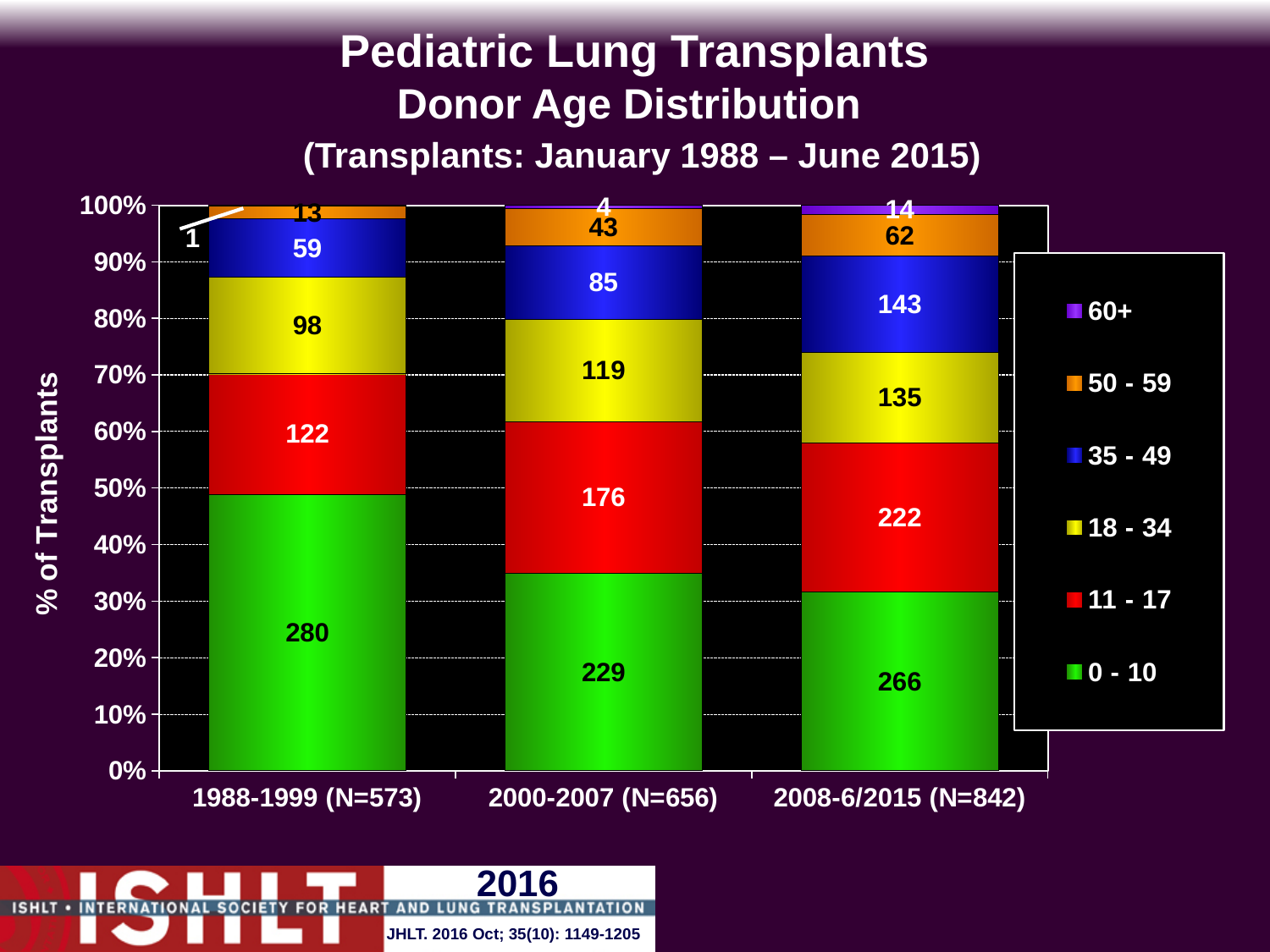
Which donor age group has the smallest count in the 1988-1999 period? 60+ Which is larger in the 2008-6/2015 period: the count for donors aged 18 - 34 or donors aged 35 - 49? 35 - 49 Which donor age group has the largest count in the 2000-2007 period? 0 - 10 How many transplants in the 2000-2007 period had donors aged 50 - 59? 43 Is the share of transplants with donors aged 0 - 10 in the 2000-2007 period greater or less than 30%? greater What is the difference between the number of transplants with donors aged 11 - 17 in 2008-6/2015 and in 2000-2007? 46 What is the number of transplants with donors aged 35 - 49 in the 2008-6/2015 period? 143 What is the total number of transplants (N) in the 2008-6/2015 period? 842 How many donor age groups does the legend list? 6 How many pediatric lung transplants in the 1988-1999 period had donors aged 0 - 10? 280 How many time periods are shown on the x axis? 3 How many transplants in the 2008-6/2015 period had donors aged 60+? 14